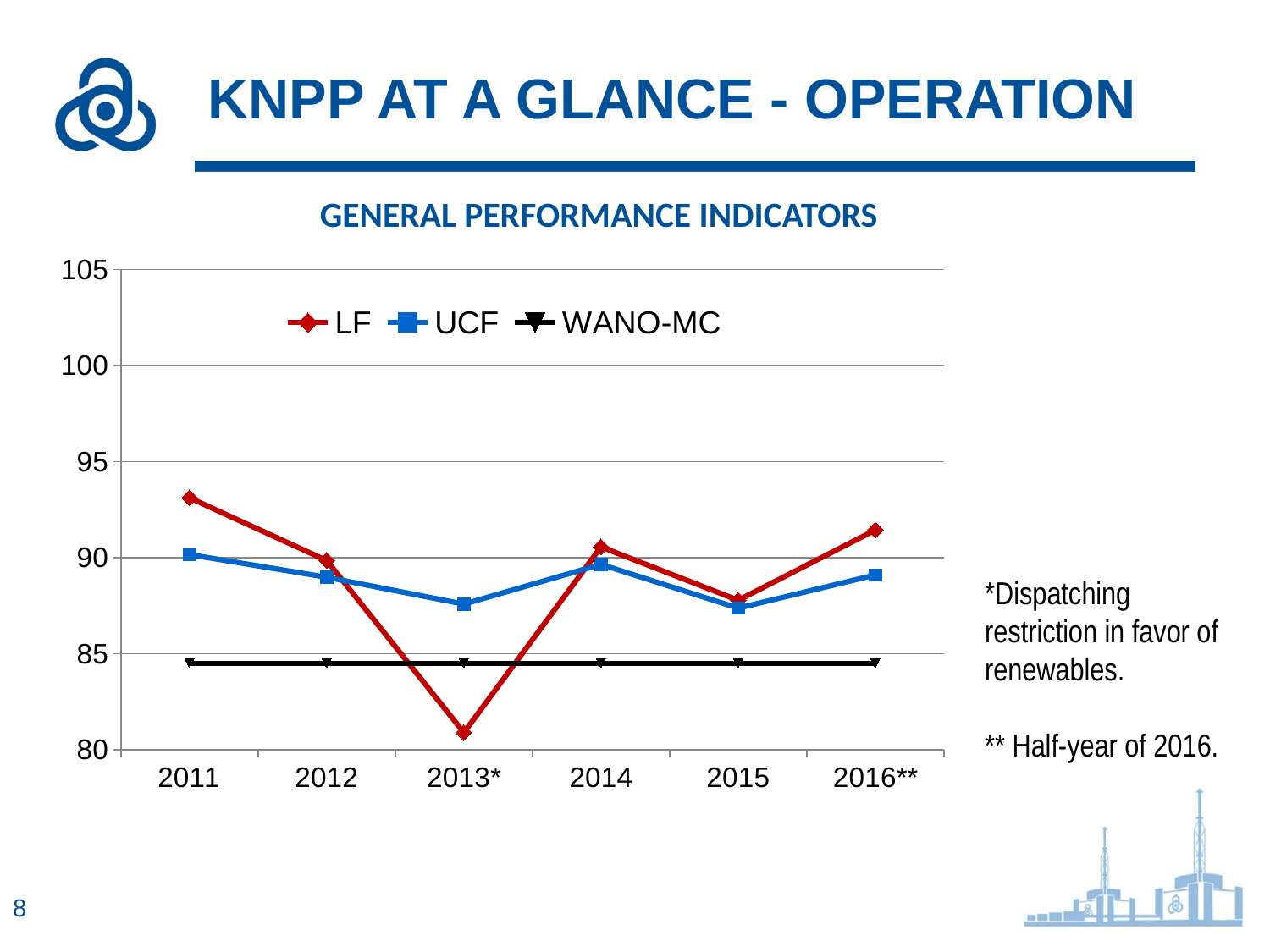
Is the WANO-MC value for 2014 greater or less than 85? less Does the LF value rise or fall from 2011 to 2013*? Fall In which year is the LF value lowest? 2013* How many series does the legend list? 3 Is the LF value for 2013* greater or less than 85? less Is the LF value for 2011 greater or less than 90? greater In which year is the UCF value highest? 2011 How many years are shown on the x axis? 6 Which is larger in 2013*, the LF value or the UCF value? UCF In which year is the LF value highest? 2011 Which series is drawn in red? LF What kind of chart is shown under "GENERAL PERFORMANCE INDICATORS"? Line chart